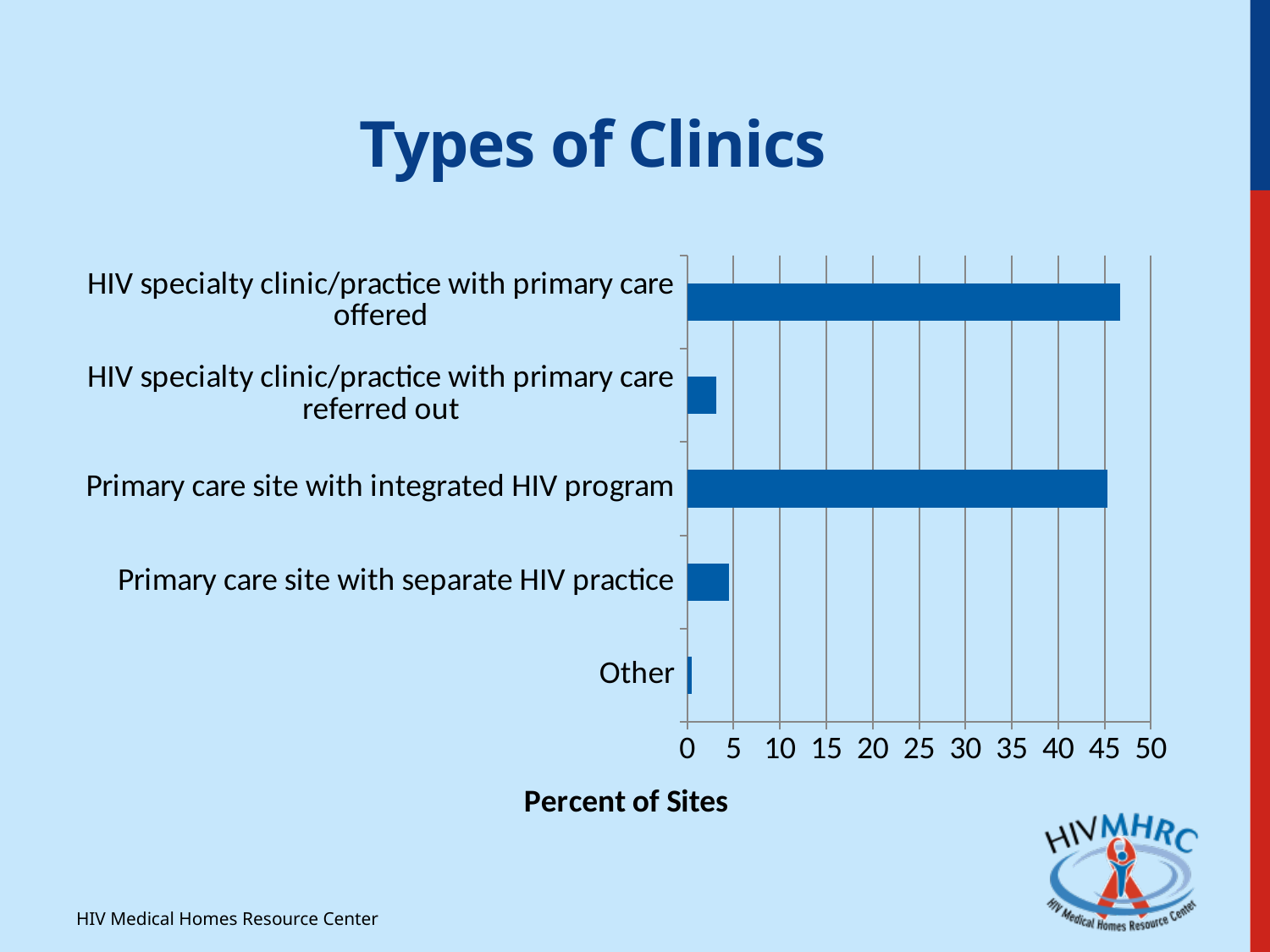
Is the value for 'Primary care site with separate HIV practice' greater or less than 10? less Is the value for 'Primary care site with integrated HIV program' greater or less than 40? greater Is the value for 'Other' greater or less than 5? less What kind of chart is shown on the slide? bar chart Which has a larger percent of sites: 'HIV specialty clinic/practice with primary care offered' or 'Primary care site with integrated HIV program'? HIV specialty clinic/practice with primary care offered Which has a larger percent of sites: 'Primary care site with separate HIV practice' or 'HIV specialty clinic/practice with primary care referred out'? Primary care site with separate HIV practice What is the title of the horizontal axis of the chart? Percent of Sites Which clinic type has the highest percent of sites? HIV specialty clinic/practice with primary care offered How many clinic types are plotted in the chart? 5 Which clinic type has the lowest percent of sites? Other